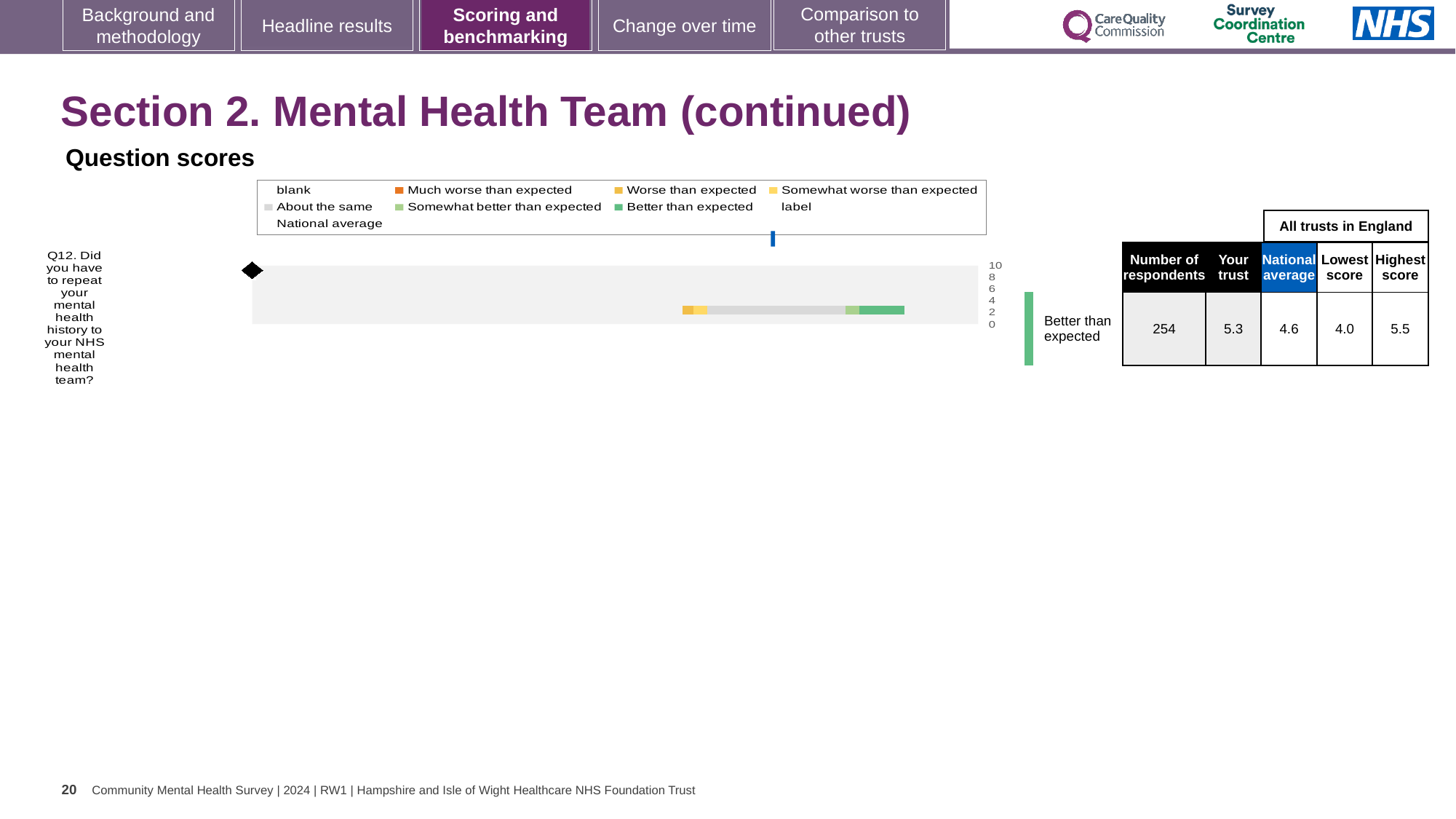
How many survey questions are plotted in the chart? 1 In the table beside the chart, what is the 'Your trust' score for Q12? 5.3 For Q12, what is the difference between the 'Your trust' score and the national average? 0.7 Which question is plotted in the chart? Q12. Did you have to repeat your mental health history to your NHS mental health team? In the table beside the chart, how many respondents answered Q12? 254 In the table beside the chart, what is the lowest score among all trusts in England for Q12? 4.0 In the table beside the chart, what is the highest score among all trusts in England for Q12? 5.5 What benchmark rating is shown for Q12 next to the chart? Better than expected In the table beside the chart, what is the national average score for Q12? 4.6 For Q12, which is higher: the 'Your trust' score or the national average? Your trust What kind of chart is used to show the Q12 question score? bar chart For Q12, what is the difference between the highest and lowest scores among all trusts in England? 1.5